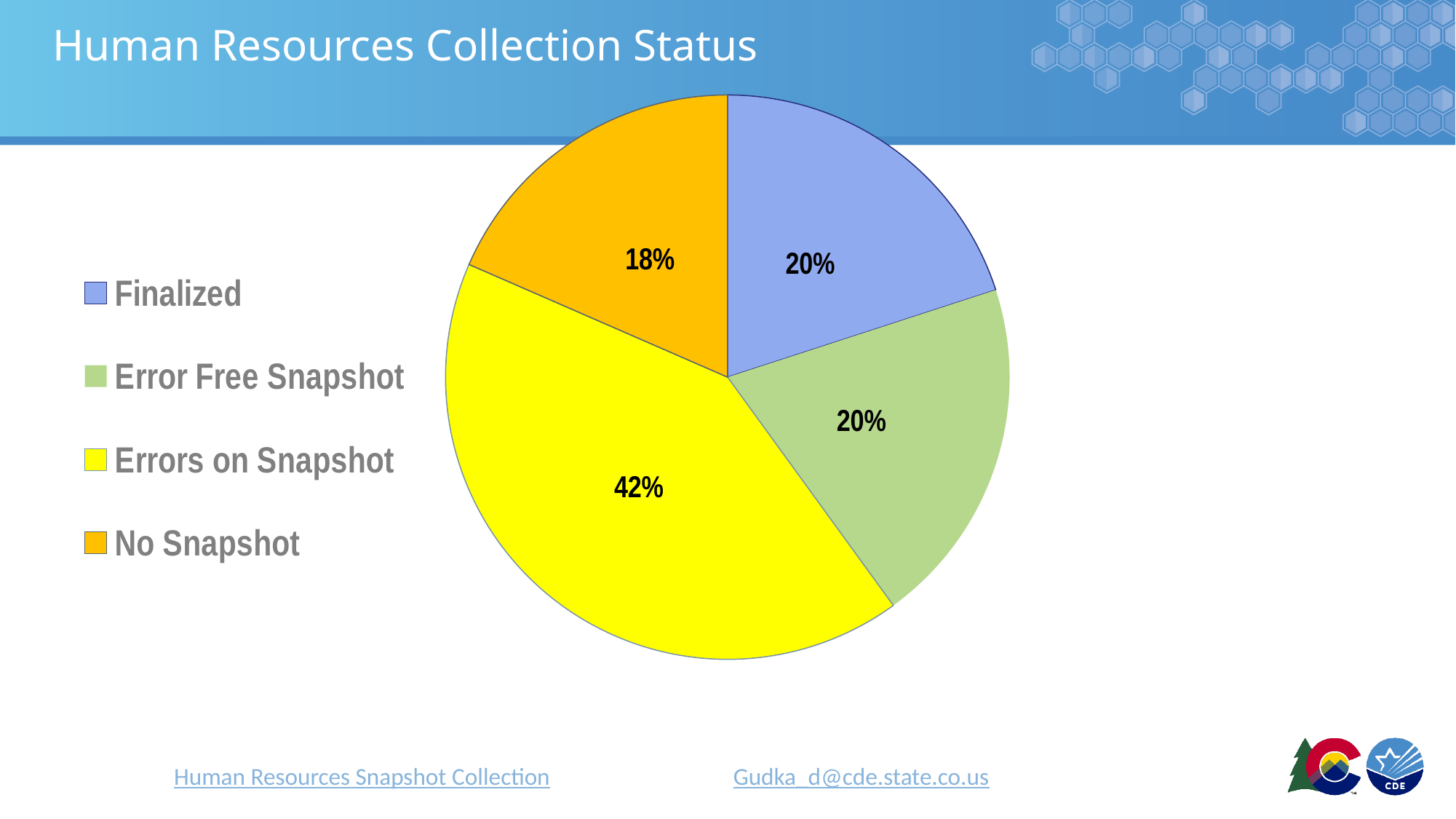
What is the difference in percentage points between Errors on Snapshot and No Snapshot? 24 What kind of chart is shown on the slide? pie chart What is the title of the slide containing the pie chart? Human Resources Collection Status What share of the pie does Error Free Snapshot represent? 20% Which is larger, the Errors on Snapshot slice or the Finalized slice? Errors on Snapshot What share of the pie does No Snapshot represent? 18% Which category has the smallest slice of the pie? No Snapshot What share of the pie does Finalized represent? 20% Which category has the largest slice of the pie? Errors on Snapshot What colour is the Errors on Snapshot slice? yellow How many categories does the pie chart have? 4